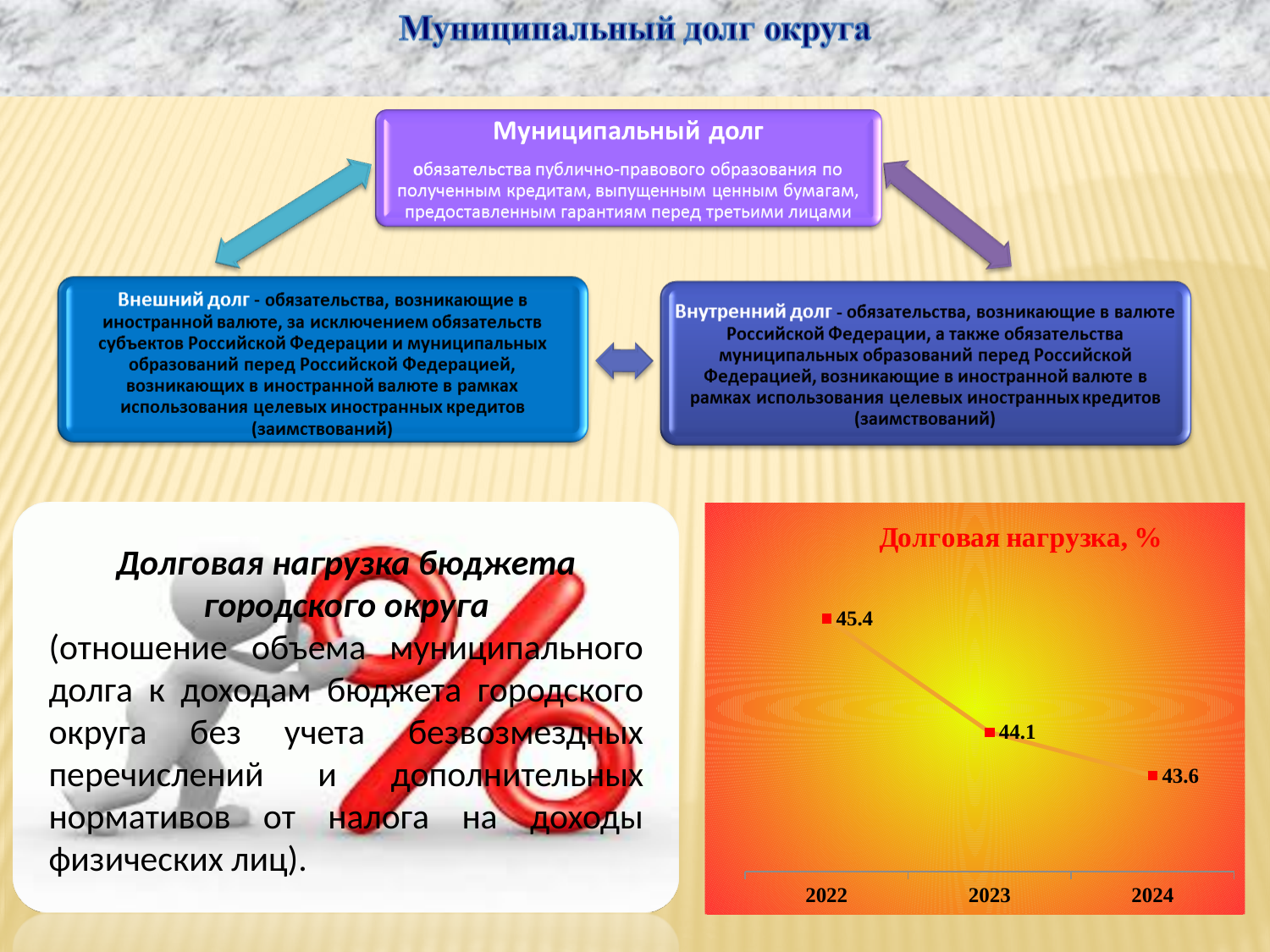
Which year has the lowest value in the 'Долговая нагрузка, %' chart? 2024 What is the difference between the 2022 and 2023 values in the 'Долговая нагрузка, %' chart? 1.3 Do the values in the 'Долговая нагрузка, %' chart rise or fall from 2022 to 2024? fall What is the title of the chart on the slide? Долговая нагрузка, % What is the value for 2023 in the 'Долговая нагрузка, %' chart? 44.1 What is the value for 2024 in the 'Долговая нагрузка, %' chart? 43.6 Which year has the highest value in the 'Долговая нагрузка, %' chart? 2022 What is the difference between the 2022 and 2024 values in the 'Долговая нагрузка, %' chart? 1.8 What is the value for 2022 in the 'Долговая нагрузка, %' chart? 45.4 What kind of chart is 'Долговая нагрузка, %'? line chart How many years are plotted in the 'Долговая нагрузка, %' chart? 3 In the 'Долговая нагрузка, %' chart, which is larger: the value for 2023 or the value for 2024? 2023